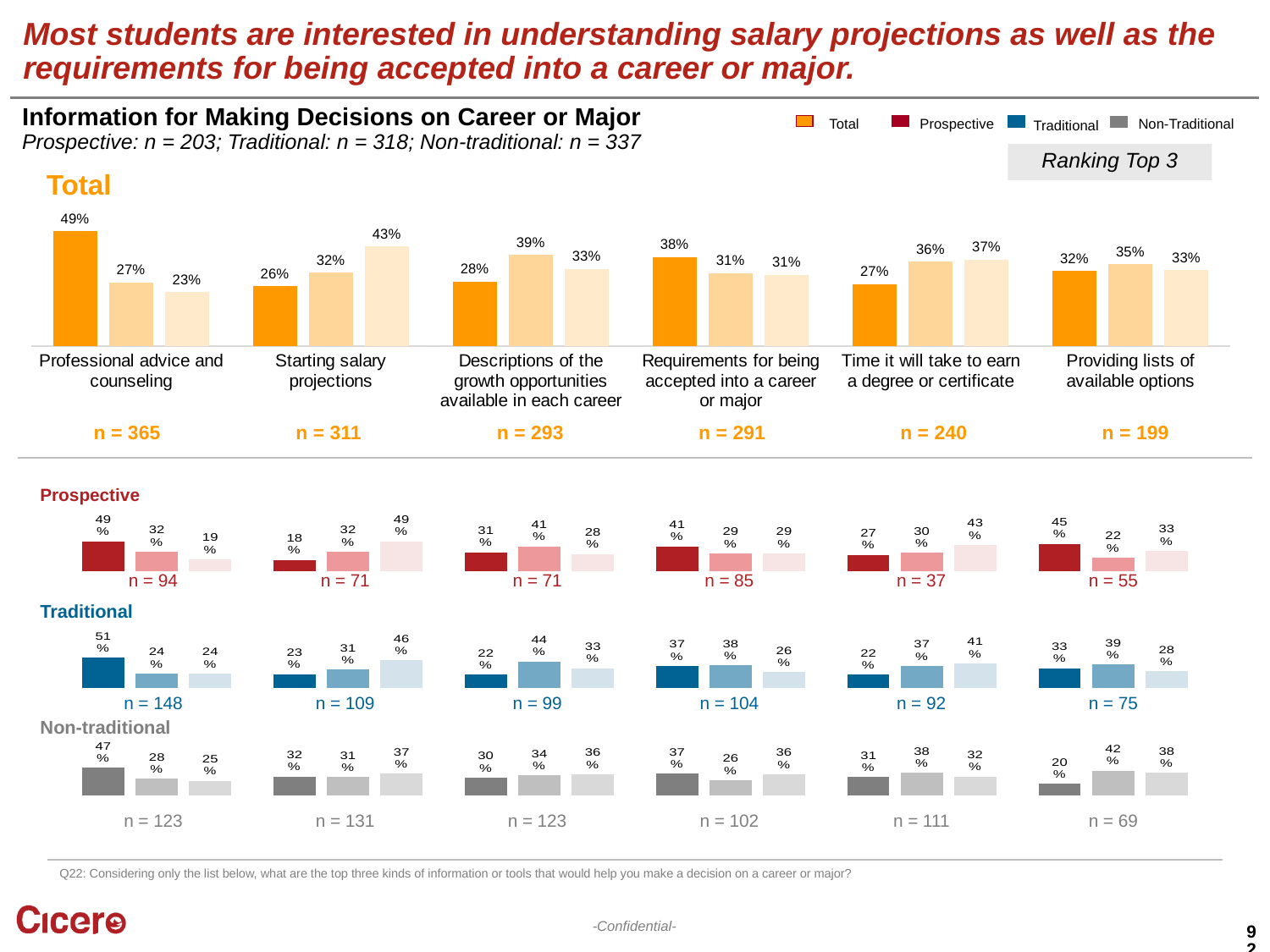
In the Total chart, what is the n value shown under Starting salary projections? n = 311 In the Total chart, what is the difference between the first bar for Professional advice and counseling (49%) and the first bar for Starting salary projections (26%)? 23 percentage points In the Total chart, which is larger: the first bar for Professional advice and counseling or the first bar for Requirements for being accepted into a career or major? Professional advice and counseling In the Non-traditional chart, what is the n value shown under Providing lists of available options? n = 69 In the Total chart, which category contains the highest labeled bar? Professional advice and counseling In the Prospective chart, what is the value of the third (rightmost) bar for Starting salary projections? 49% How many series does the legend at the top of the slide list? 4 What type of chart is used on this slide? Bar chart In the Traditional chart, what is the value of the first (leftmost) bar for Professional advice and counseling? 51% How many categories are shown along the x axis of the Total chart? 6 In the Total chart, what is the value of the first (leftmost) bar for Professional advice and counseling? 49% What does the grey box in the top right corner of the chart area say? Ranking Top 3